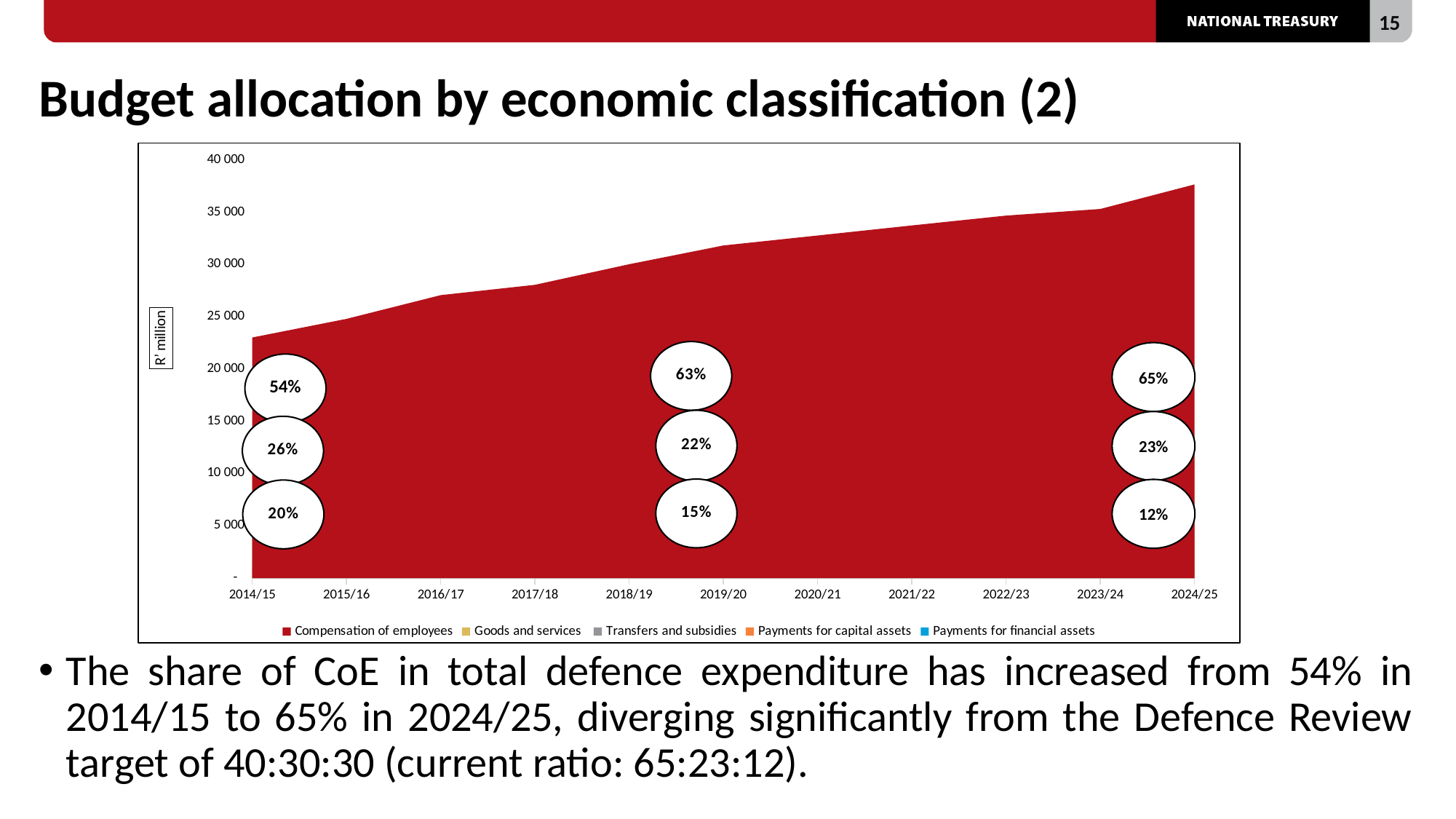
How many series does the chart legend list? 5 Is the value for Compensation of employees in 2021/22 greater or less than 35 000? less What kind of chart is shown on the slide? Area chart Which year has the highest value for Compensation of employees on the chart? 2024/25 Does the plotted area for Compensation of employees rise or fall from 2014/15 to 2024/25? Rises Which year has the lowest value for Compensation of employees on the chart? 2014/15 What percentage is shown in the top callout bubble above 2019/20 on the chart? 63% How many financial years are shown on the x axis of the chart? 11 Is the value for Compensation of employees in 2024/25 greater or less than 35 000? greater Is the value for Compensation of employees in 2014/15 greater or less than 25 000? less What unit label is shown on the y axis of the chart? R' million